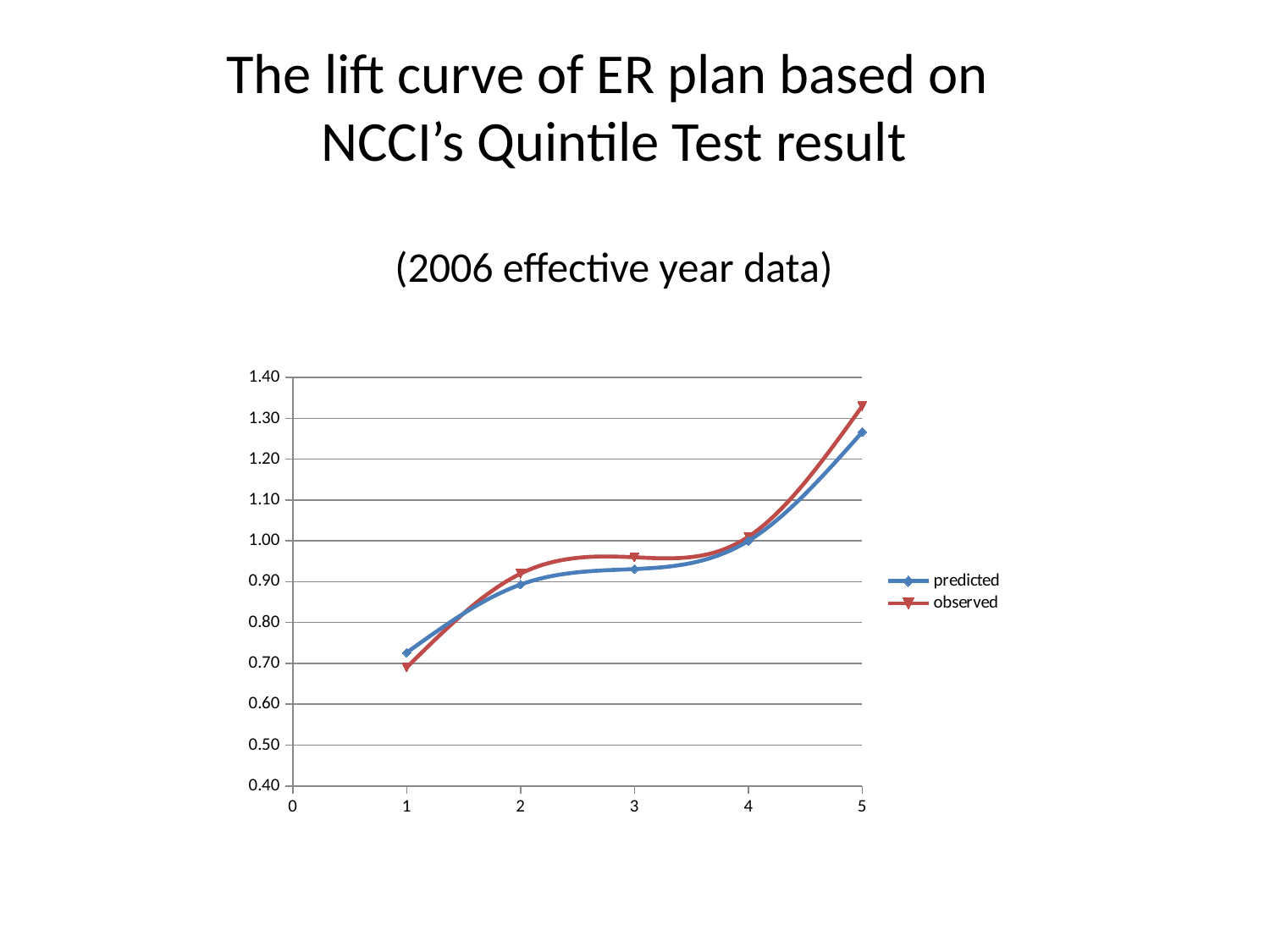
At x = 5, which series has the larger value, predicted or observed? observed Is the value of the predicted series at x = 5 greater or less than 1.20? greater Is the value of the predicted series at x = 1 greater or less than 0.80? less What are the names of the two series in the legend? predicted and observed At which x value is the predicted series highest? 5 What kind of chart is shown on the slide? line chart At x = 1, which series has the larger value, predicted or observed? predicted How many data points does the predicted series have? 5 Is the value of the observed series at x = 3 greater or less than 1.00? less At which x value is the observed series lowest? 1 How many series does the legend list? 2 Do the values of the observed series rise or fall as x increases from 1 to 5? rise